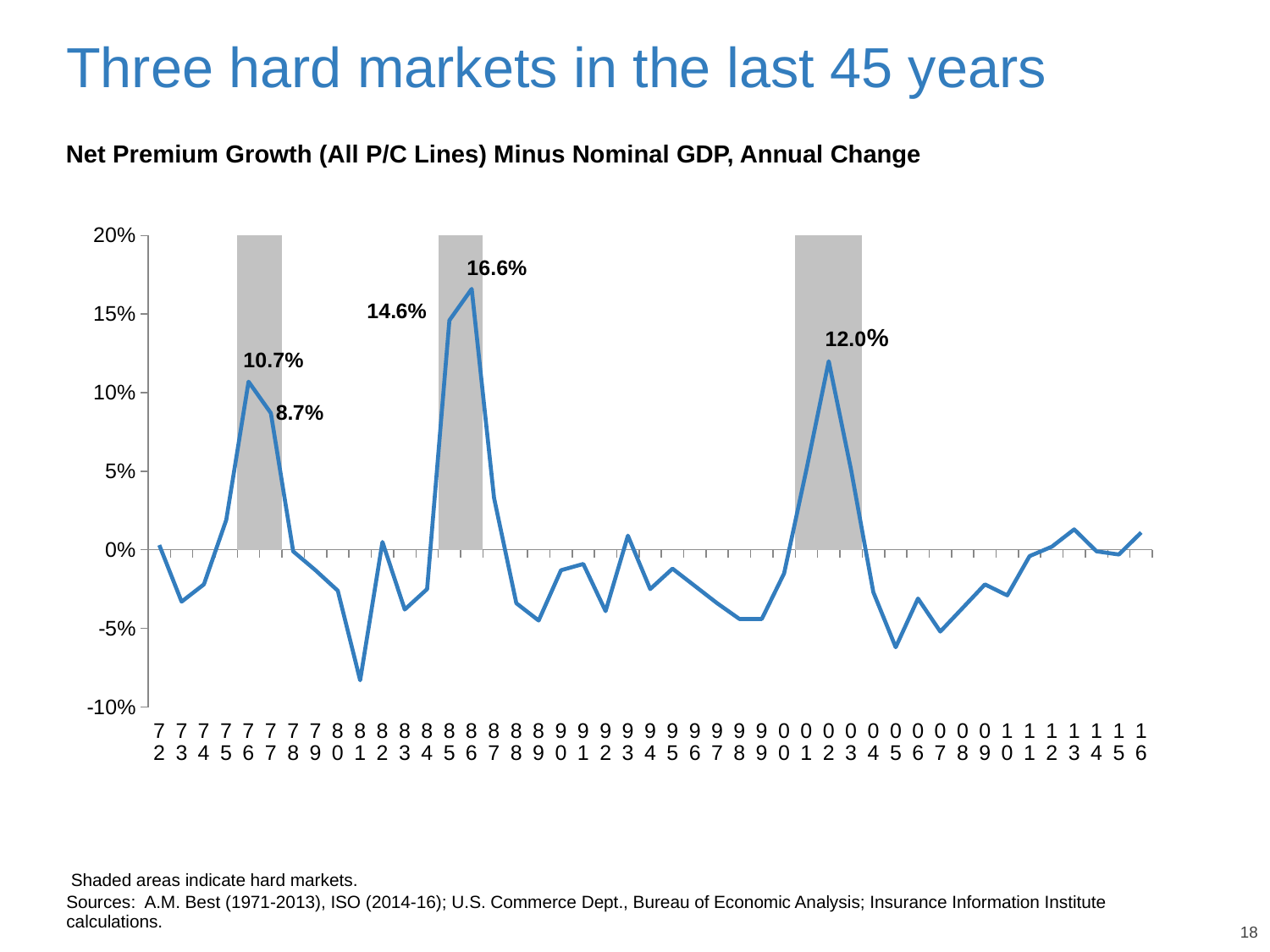
Which is larger, the value for 85 or the value for 02? 85 Which year has the highest value on the chart? 86 What is the difference between the labeled values for 86 and 85? 2.0 percentage points Is the value for 81 greater or less than -5%? less What is the value labeled for the year 76? 10.7% How many shaded areas indicating hard markets are shown on the chart? 3 What is the difference between the labeled values for 76 and 77? 2.0 percentage points What is the value labeled for the year 02? 12.0% How many years are plotted along the x axis? 45 What is the value labeled for the year 86? 16.6% What kind of chart is shown on the slide? line chart What is the value labeled for the year 85? 14.6%